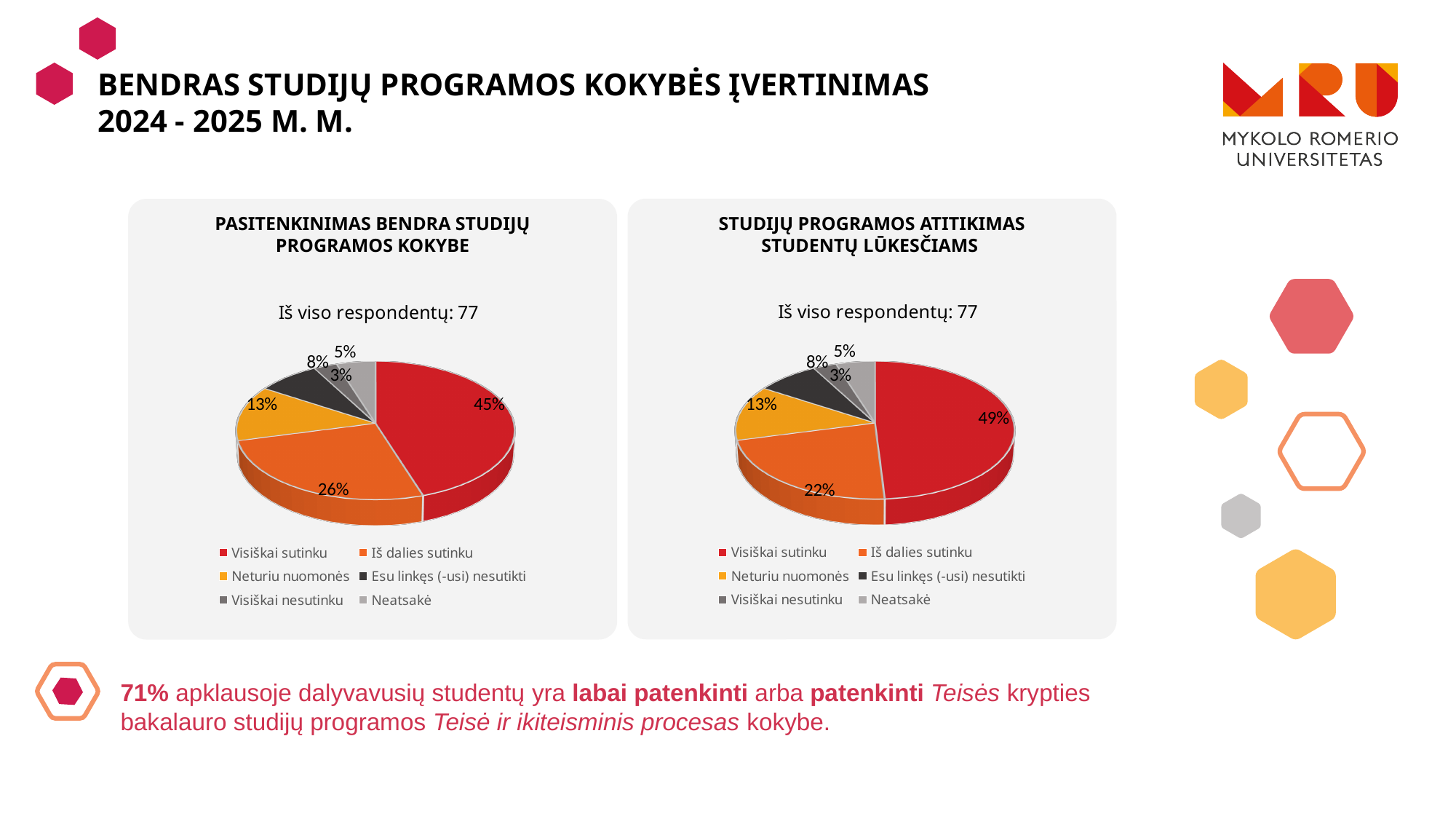
In the left chart, 'Pasitenkinimas bendra studijų programos kokybe', what is the difference between 'Visiškai sutinku' and 'Iš dalies sutinku'? 19% In the left chart, 'Pasitenkinimas bendra studijų programos kokybe', what share is 'Iš dalies sutinku'? 26% How many respondents does the right chart, 'Studijų programos atitikimas studentų lūkesčiams', report in total? 77 In the left chart, 'Pasitenkinimas bendra studijų programos kokybe', what share is 'Visiškai sutinku'? 45% In the right chart, 'Studijų programos atitikimas studentų lūkesčiams', which category has the largest share? Visiškai sutinku In the right chart, 'Studijų programos atitikimas studentų lūkesčiams', what share is 'Neatsakė'? 5% What type of chart is used in the left chart, 'Pasitenkinimas bendra studijų programos kokybe'? pie chart In the right chart, 'Studijų programos atitikimas studentų lūkesčiams', what share is 'Iš dalies sutinku'? 22% How many categories does the legend of the left chart, 'Pasitenkinimas bendra studijų programos kokybe', list? 6 In the left chart, 'Pasitenkinimas bendra studijų programos kokybe', which category has the smallest share? Visiškai nesutinku Which chart has the larger share for 'Visiškai sutinku', the left chart or the right chart? the right chart In the right chart, 'Studijų programos atitikimas studentų lūkesčiams', what share is 'Visiškai sutinku'? 49%